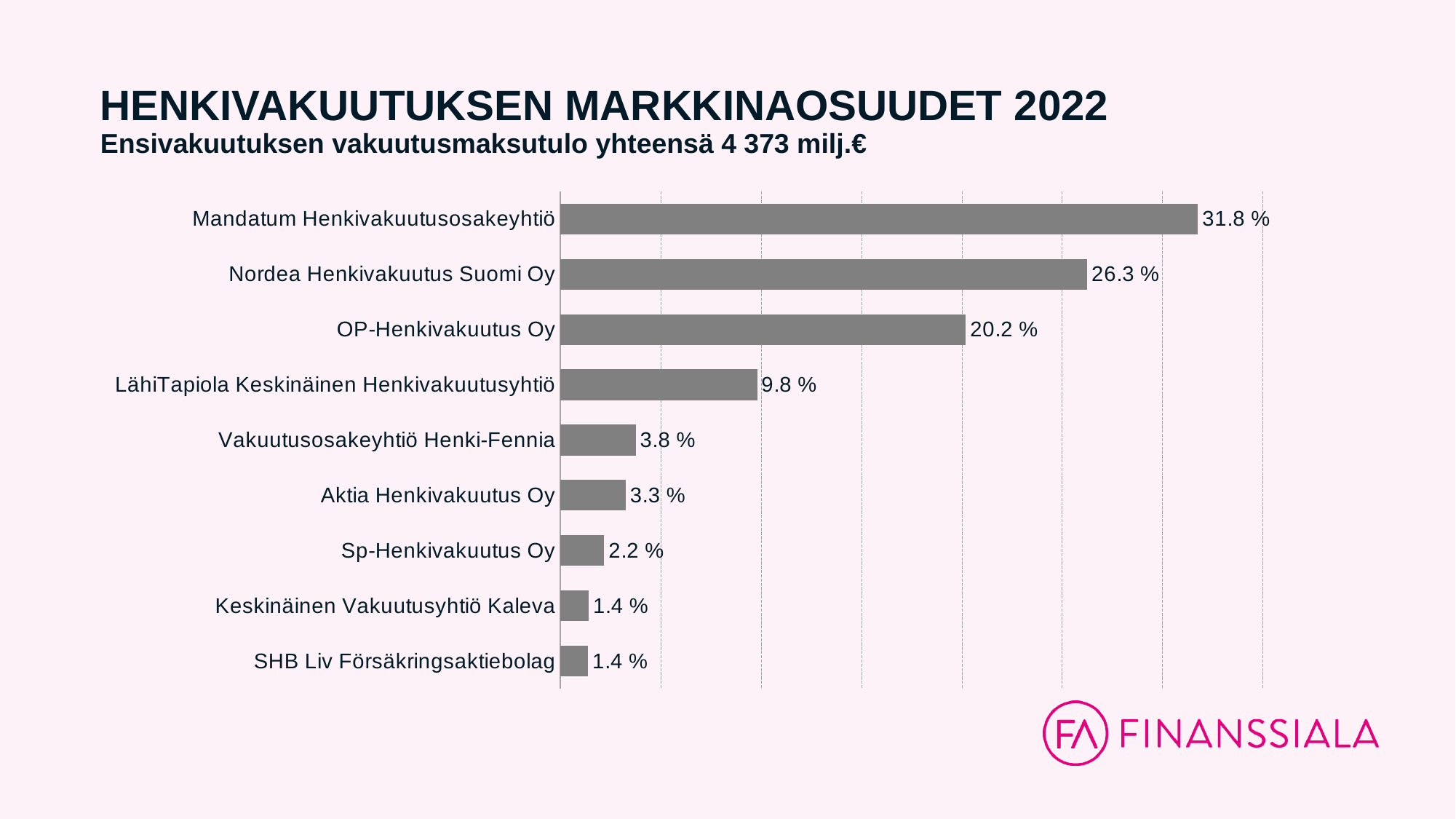
According to the subtitle, what is the total premium income (Ensivakuutuksen vakuutusmaksutulo yhteensä)? 4 373 milj.€ How many companies are shown on the chart? 9 What is the difference in market share between OP-Henkivakuutus Oy and LähiTapiola Keskinäinen Henkivakuutusyhtiö? 10.4 % What is the difference in market share between Mandatum Henkivakuutusosakeyhtiö and Nordea Henkivakuutus Suomi Oy? 5.5 % What is the market share shown for OP-Henkivakuutus Oy? 20.2 % What is the market share shown for Mandatum Henkivakuutusosakeyhtiö? 31.8 % What kind of chart is shown on the slide? Bar chart Which has a larger market share, Vakuutusosakeyhtiö Henki-Fennia or Sp-Henkivakuutus Oy? Vakuutusosakeyhtiö Henki-Fennia What is the combined market share of Keskinäinen Vakuutusyhtiö Kaleva and SHB Liv Försäkringsaktiebolag? 2.8 % Which company has the highest market share on the chart? Mandatum Henkivakuutusosakeyhtiö What is the market share shown for Aktia Henkivakuutus Oy? 3.3 % What is the title of the chart on the slide? HENKIVAKUUTUKSEN MARKKINAOSUUDET 2022